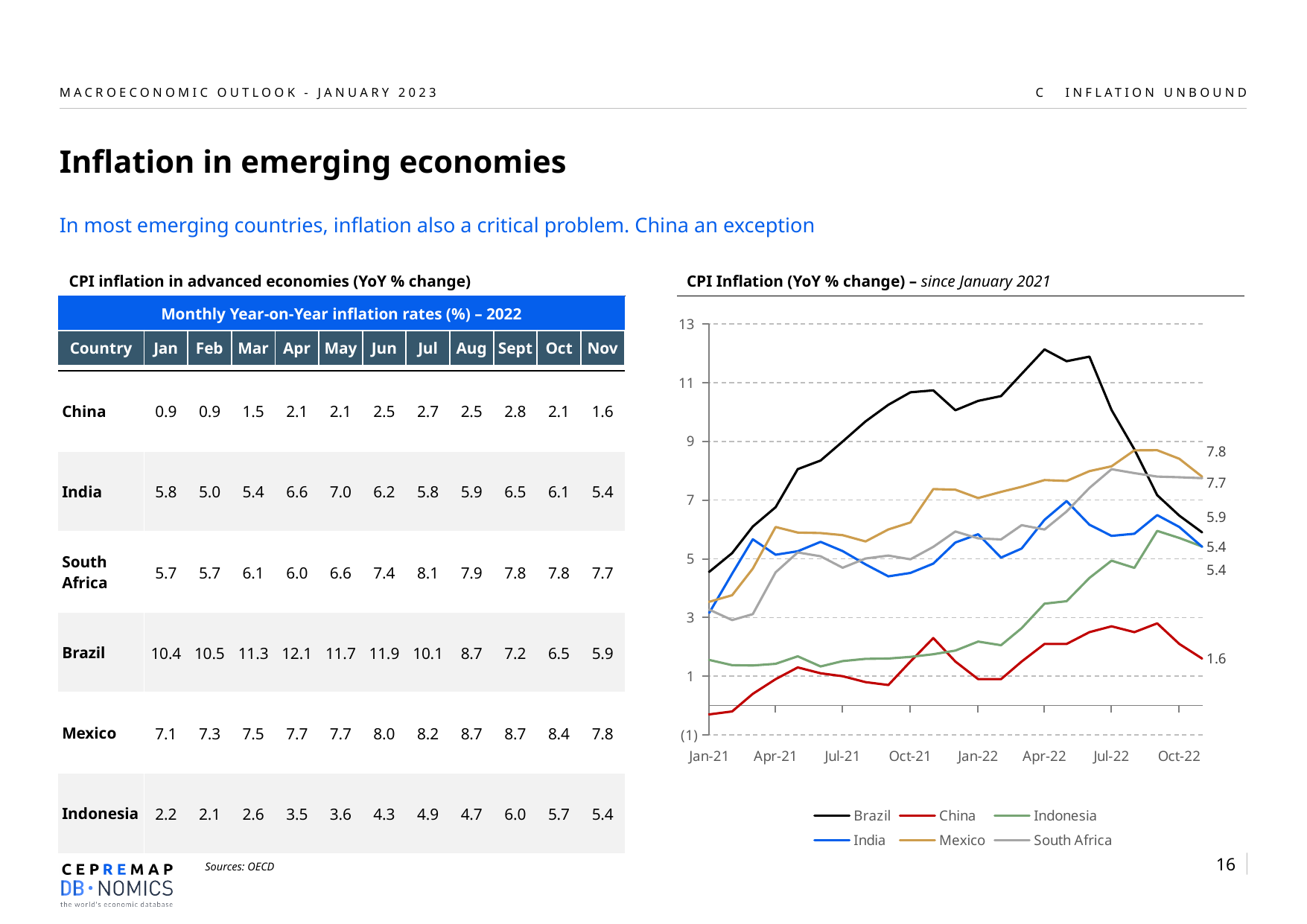
How many series does the legend of the CPI Inflation line chart list? 6 In the CPI Inflation line chart, what colour is the Brazil line? black In the CPI Inflation line chart, what is the final labelled value for Brazil? 5.9 In the CPI Inflation line chart, which country has the highest value at the end of the series? Mexico In the CPI Inflation line chart, what is the final labelled value for Mexico? 7.8 What kind of chart is the 'CPI Inflation (YoY % change) – since January 2021' chart? line chart In the CPI Inflation line chart, does Brazil's line rise or fall between Apr-22 and Oct-22? fall In the CPI Inflation line chart, what is the final labelled value for China? 1.6 In the CPI Inflation line chart, is Brazil's peak value greater or less than 11? greater In the CPI Inflation line chart, which country has the lowest value at the end of the series? China In the CPI Inflation line chart, is China's value in Jan-21 greater or less than 1? less In the CPI Inflation line chart, what is the difference between the final values of Mexico and China? 6.2